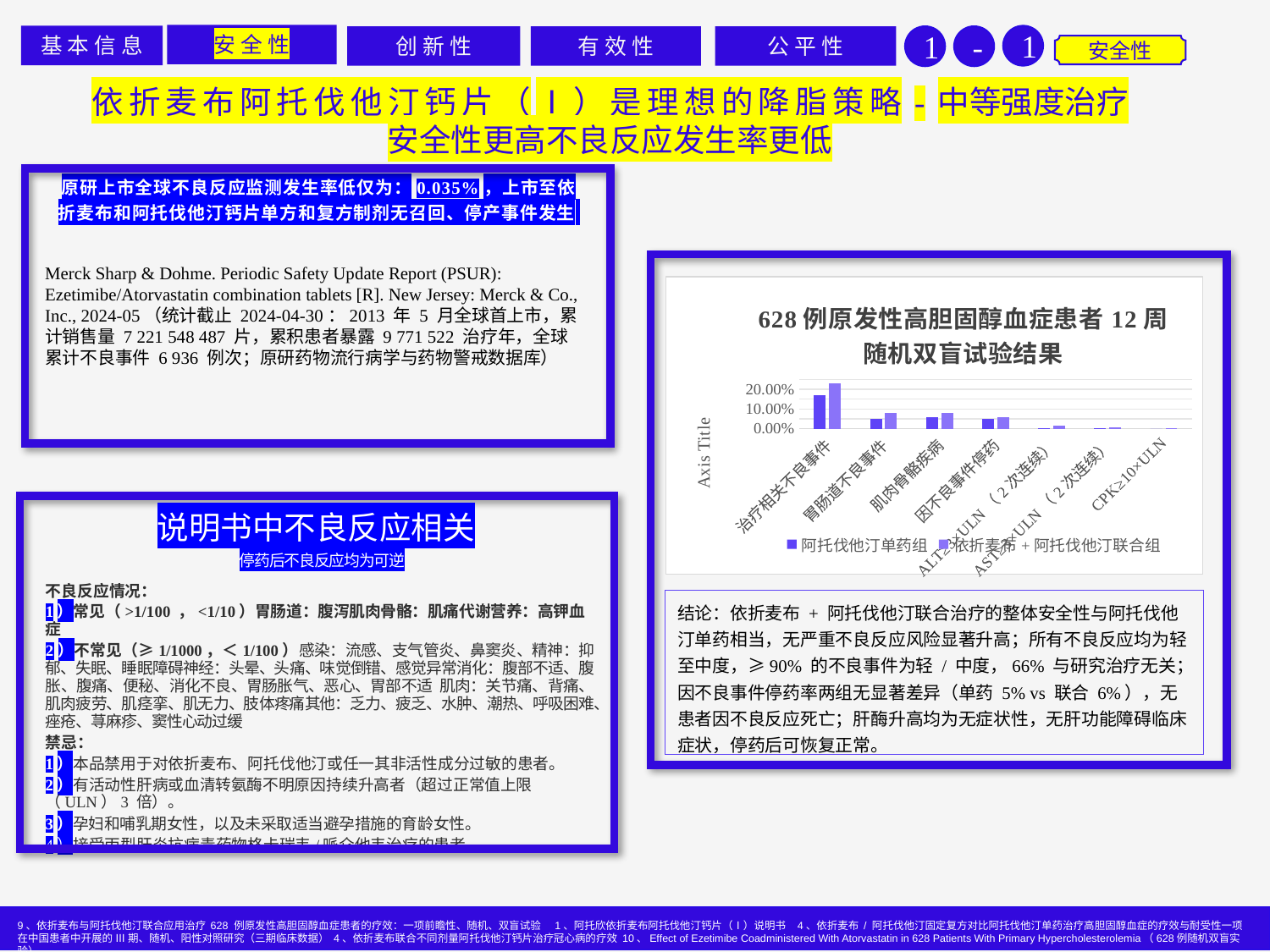
Is the value for 治疗相关不良事件 in the 阿托伐他汀单药组 series greater or less than 10.00%? greater What is the highest tick value shown on the chart's vertical axis? 20.00% Is the value for 因不良事件停药 in the 阿托伐他汀单药组 series greater or less than 10.00%? less Which category has the highest value for the 依折麦布 + 阿托伐他汀联合组 series? 治疗相关不良事件 What is the label shown on the vertical axis of the chart? Axis Title How many categories are plotted along the x axis of the chart? 7 Is the value for 胃肠道不良事件 in the 依折麦布 + 阿托伐他汀联合组 series greater or less than 10.00%? less What is the title of the chart? 628 例原发性高胆固醇血症患者 12 周随机双盲试验结果 Which category has the highest value for the 阿托伐他汀单药组 series? 治疗相关不良事件 What kind of chart is shown on the slide? bar chart For 治疗相关不良事件, which series has the larger value: 阿托伐他汀单药组 or 依折麦布 + 阿托伐他汀联合组? 依折麦布 + 阿托伐他汀联合组 How many series does the chart's legend list? 2